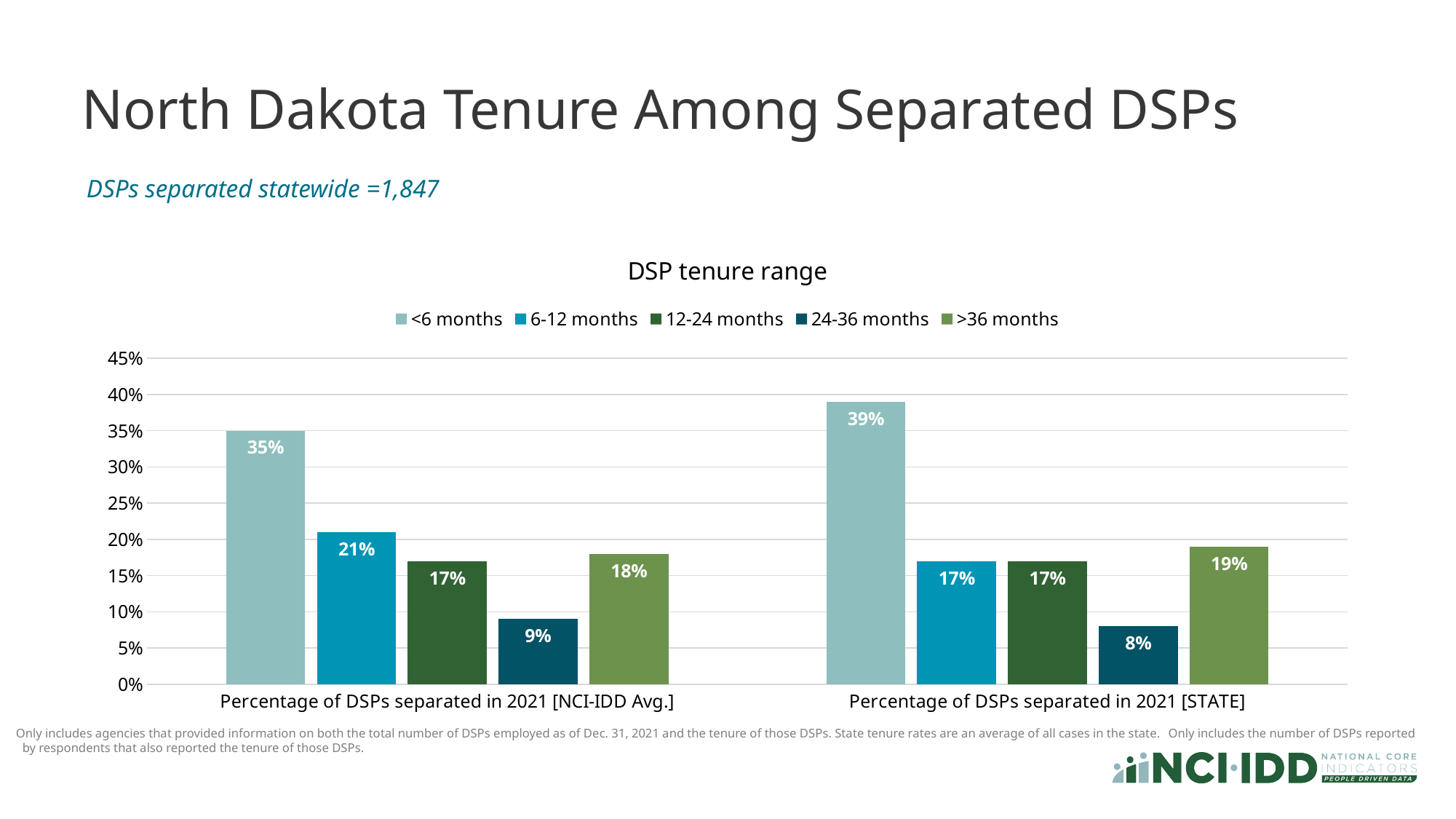
What is the difference between the <6 months values for the [STATE] group and the [NCI-IDD Avg.] group? 4% Which is larger: the 6-12 months value for the [NCI-IDD Avg.] group or for the [STATE] group? [NCI-IDD Avg.] Which tenure range has the highest value in the Percentage of DSPs separated in 2021 [STATE] group? <6 months Which tenure range has the lowest value in the Percentage of DSPs separated in 2021 [NCI-IDD Avg.] group? 24-36 months What is the title of the chart? DSP tenure range What is the value for 24-36 months in the Percentage of DSPs separated in 2021 [STATE] group? 8% What is the value for 6-12 months in the Percentage of DSPs separated in 2021 [NCI-IDD Avg.] group? 21% What is the value for <6 months in the Percentage of DSPs separated in 2021 [STATE] group? 39% What is the value for >36 months in the Percentage of DSPs separated in 2021 [NCI-IDD Avg.] group? 18% Is the value for <6 months in the [NCI-IDD Avg.] group greater or less than 30%? greater How many series does the legend list? 5 What kind of chart is shown on the slide? Bar chart